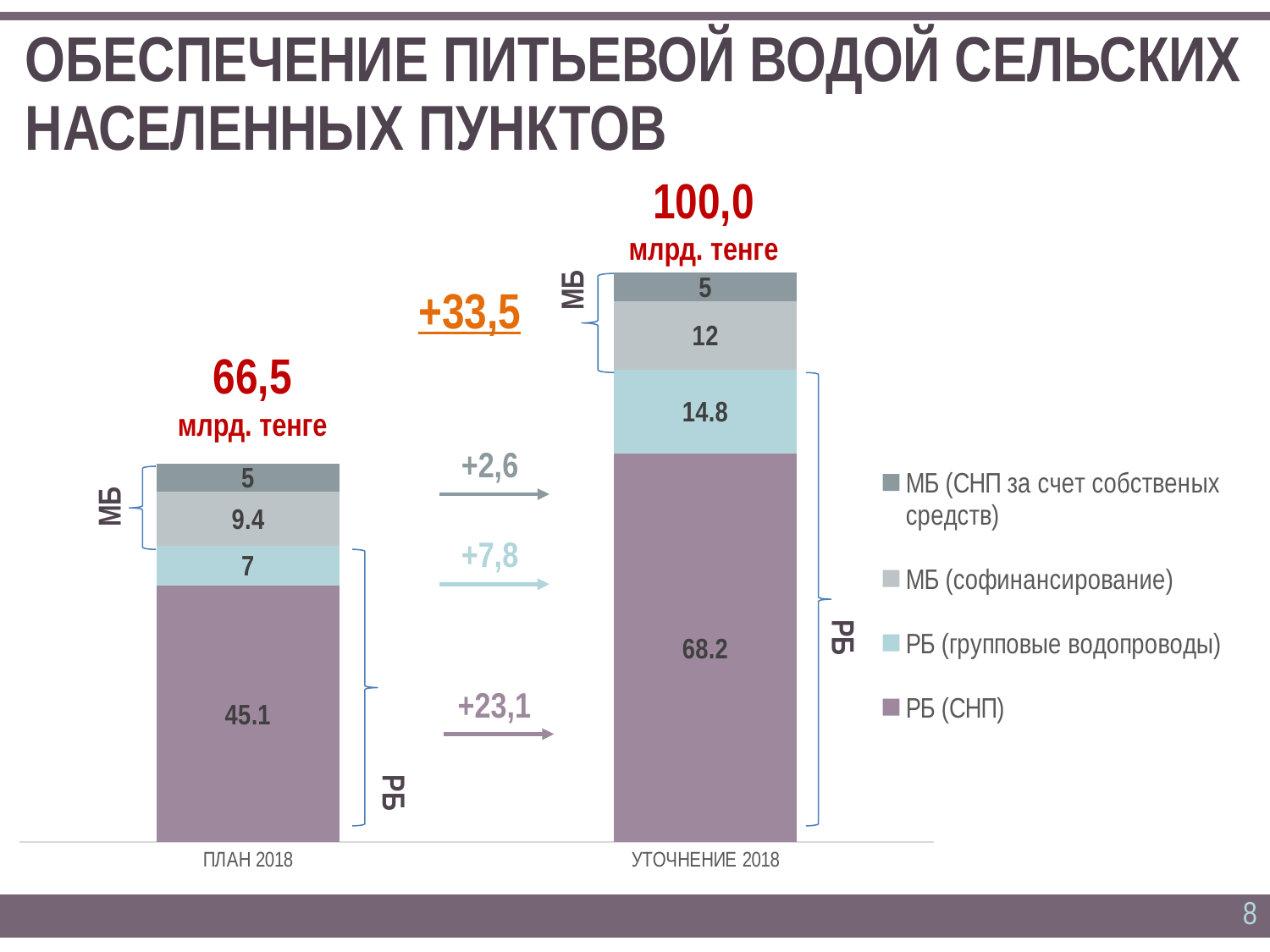
What is the total of the stacked bar for УТОЧНЕНИЕ 2018? 100,0 млрд. тенге What is the value of РБ (СНП) for ПЛАН 2018? 45.1 What type of chart is shown on the slide? Stacked bar chart What is the value of РБ (СНП) for УТОЧНЕНИЕ 2018? 68.2 Which category has the larger value for РБ (групповые водопроводы), ПЛАН 2018 or УТОЧНЕНИЕ 2018? УТОЧНЕНИЕ 2018 What is the difference in РБ (СНП) between УТОЧНЕНИЕ 2018 and ПЛАН 2018? 23.1 What is the value of МБ (софинансирование) for ПЛАН 2018? 9.4 What is the value of РБ (групповые водопроводы) for УТОЧНЕНИЕ 2018? 14.8 How many categories are shown on the x axis of the chart? 2 Which series has the largest value in the УТОЧНЕНИЕ 2018 bar? РБ (СНП) What is the total of the stacked bar for ПЛАН 2018? 66,5 млрд. тенге How many series does the chart legend list? 4